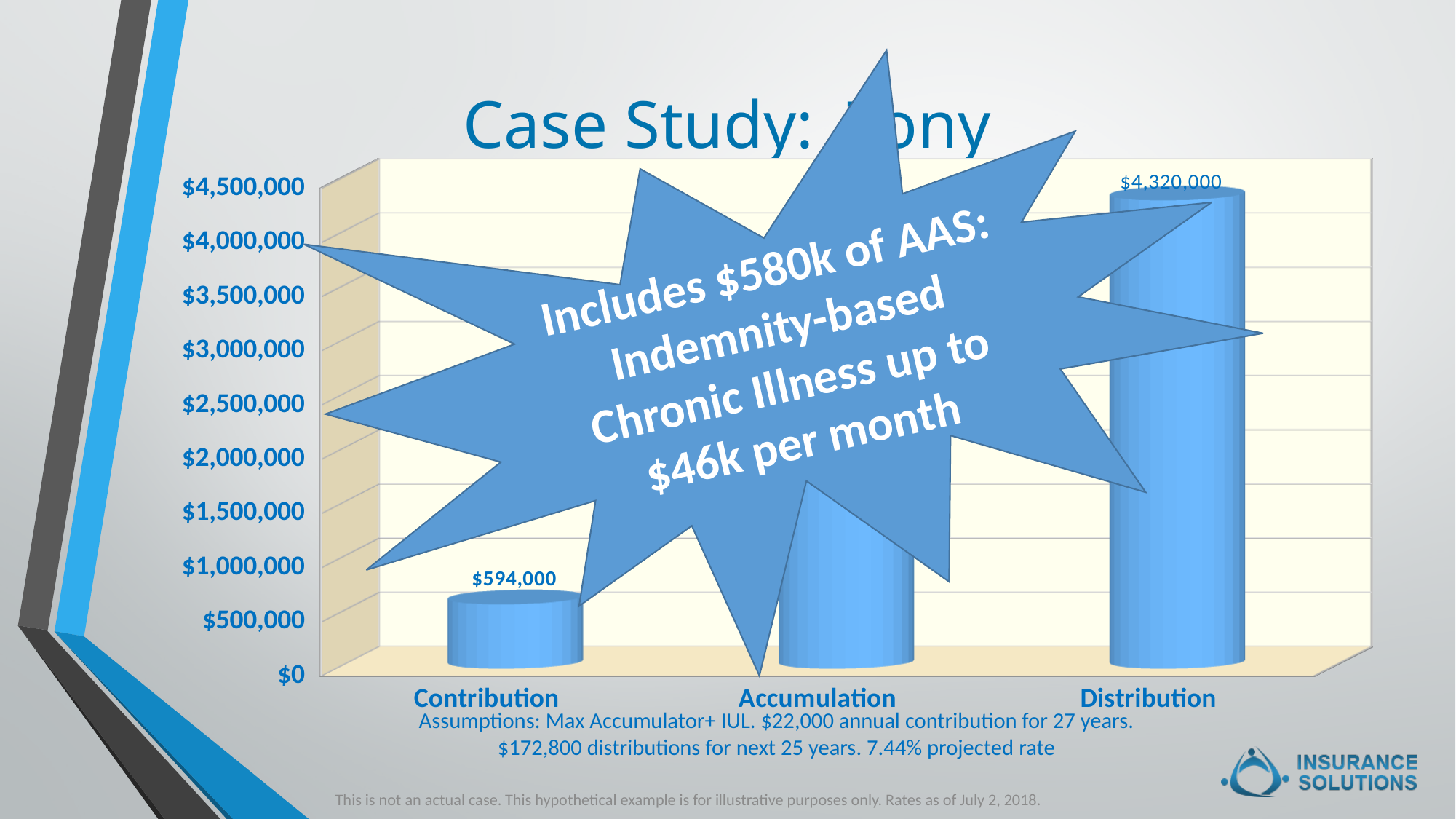
Is the value for Contribution greater or less than $1,000,000? less Is the value for Accumulation greater or less than $1,000,000? greater How many categories are shown on the x axis? 3 What is the value for Contribution? $594,000 What kind of chart is shown on the slide? Bar chart Is the value for Distribution greater or less than $4,000,000? greater Which is larger, the value for Accumulation or the value for Contribution? Accumulation What is the value for Distribution? $4,320,000 What is the highest value shown on the y axis? $4,500,000 Which category has the lowest value? Contribution What is the difference between the Distribution and Contribution values? $3,726,000 Which is larger, the value for Distribution or the value for Contribution? Distribution